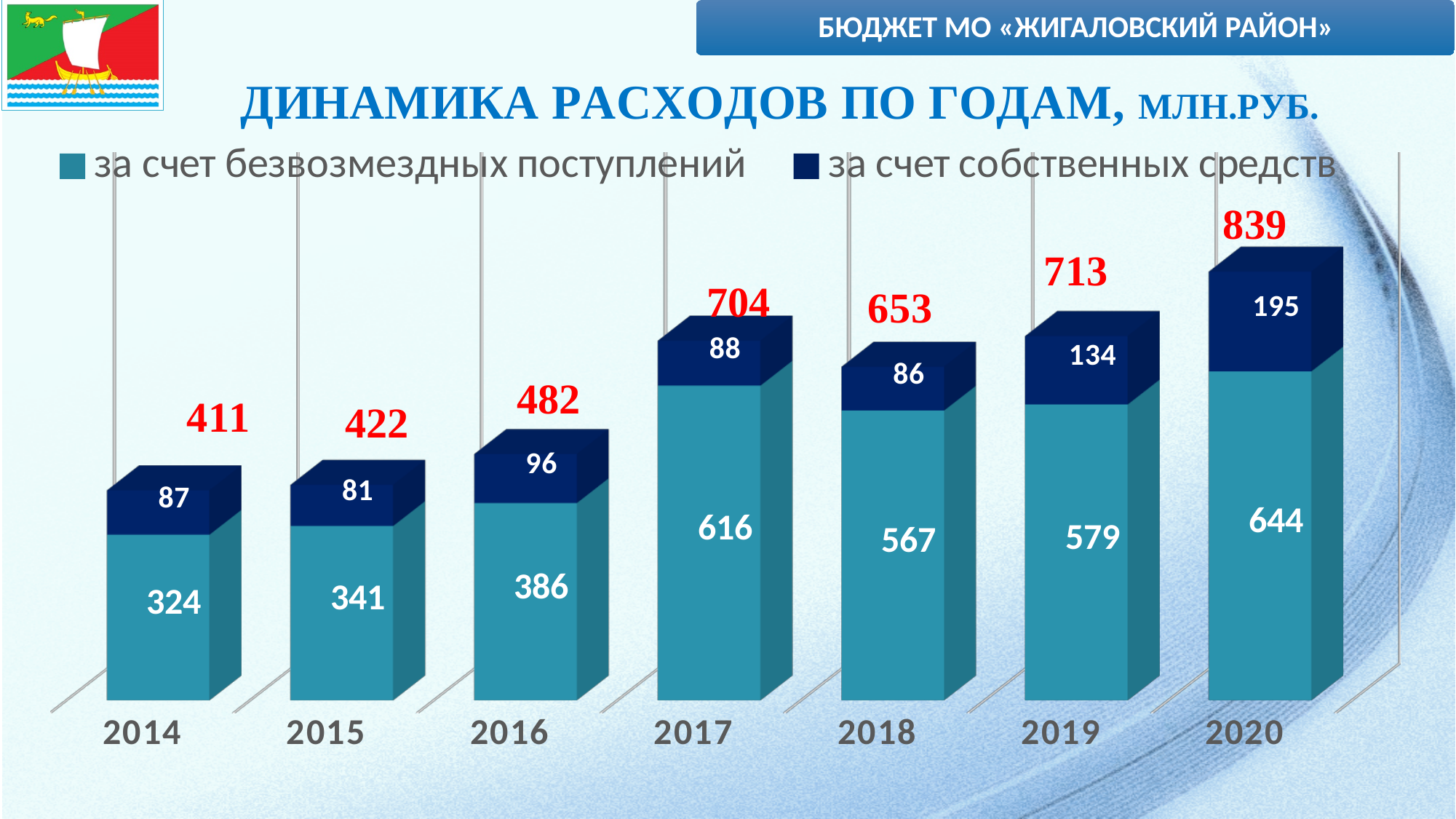
How many years are shown on the x axis? 7 What is the total of the stacked bar for 2019? 713 Which is larger: the "за счет собственных средств" value for 2016 or for 2018? 2016 What kind of chart is shown on the slide? Stacked bar chart What is the title of the chart? ДИНАМИКА РАСХОДОВ ПО ГОДАМ, МЛН.РУБ. What is the value for "за счет собственных средств" in 2015? 81 Which year has the lowest total expenditure? 2014 What is the difference between the "за счет безвозмездных поступлений" values for 2020 and 2014? 320 What is the value for "за счет собственных средств" in 2020? 195 What is the value for "за счет безвозмездных поступлений" in 2017? 616 Which year has the highest total expenditure? 2020 How many series does the legend list? 2